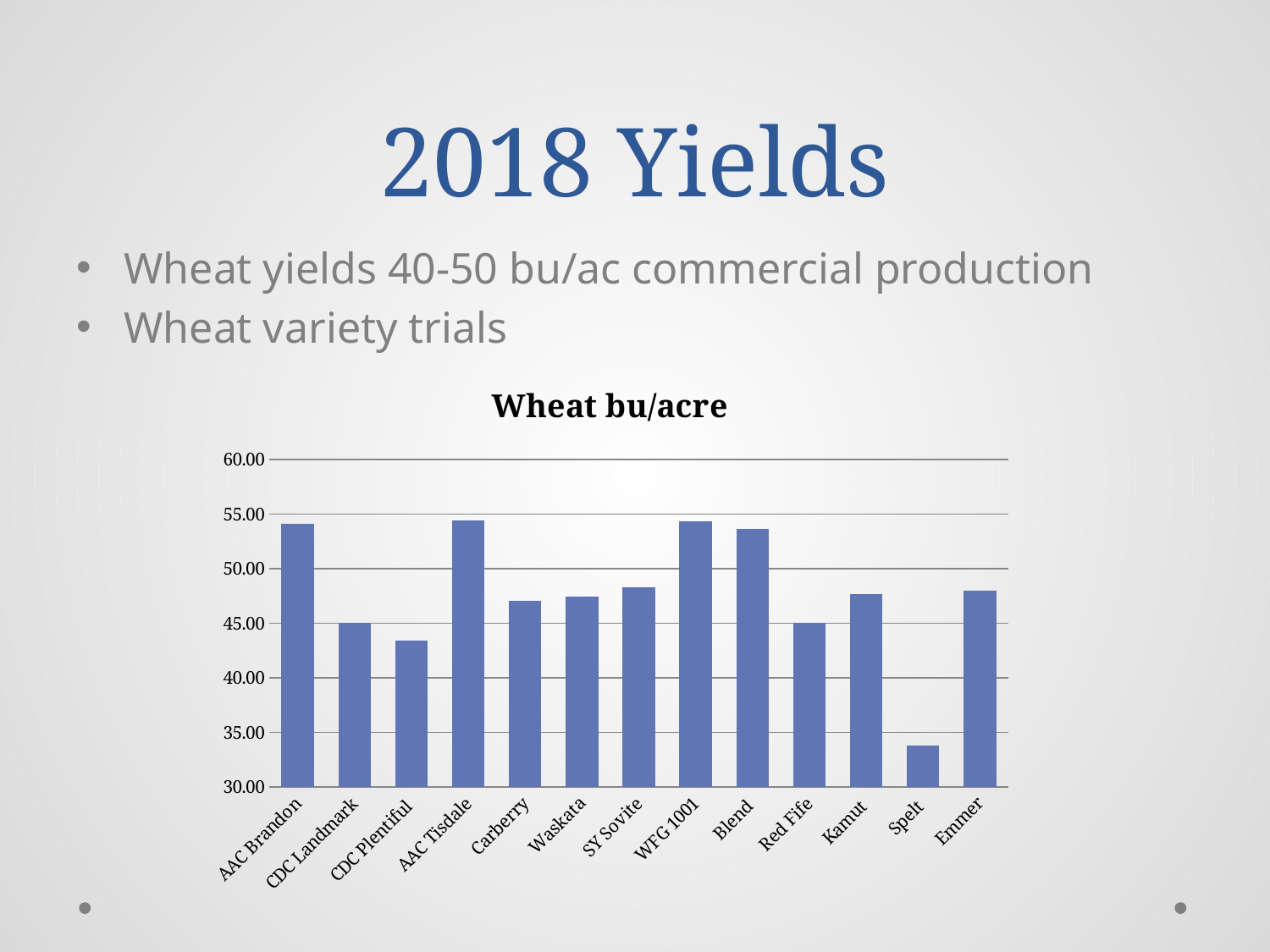
Which has the higher yield, Spelt or Emmer? Emmer Is the value for Blend greater or less than 50.00? greater What type of chart is shown on the slide? Bar chart Is the value for Spelt greater or less than 35.00? less How many wheat varieties are plotted in the chart? 13 Is the value for Emmer greater or less than 50.00? less What is the highest value shown on the vertical axis? 60.00 What is the title of the chart? Wheat bu/acre Which variety has the lowest yield in the chart? Spelt Which has the higher yield, CDC Plentiful or AAC Tisdale? AAC Tisdale